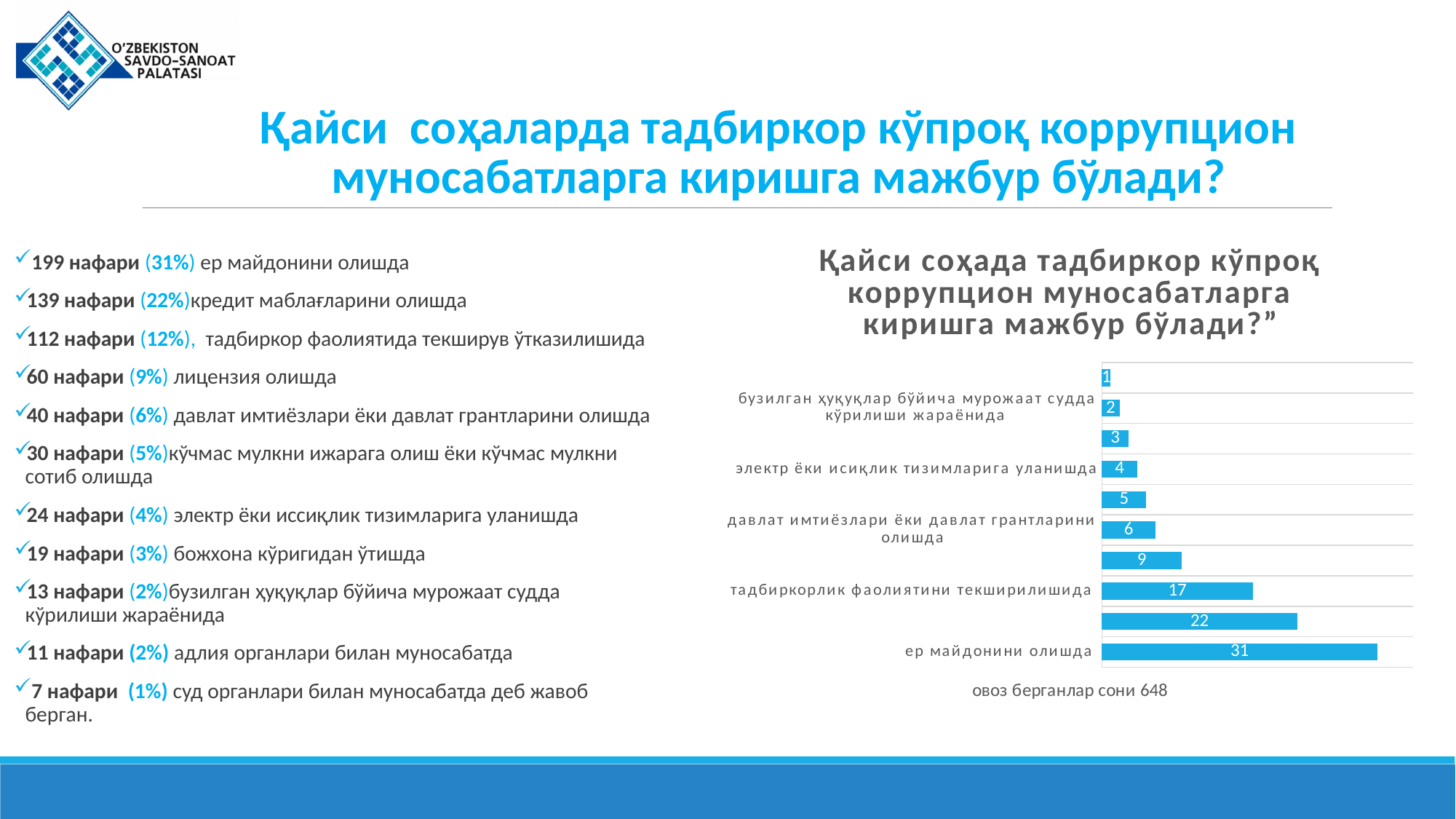
In the bar chart, what is the value for "ер майдонини олишда"? 31 What is the difference between the values for "ер майдонини олишда" and "тадбиркорлик фаолиятини текширилишида" in the bar chart? 14 What is the smallest value shown on any bar in the chart? 1 In the bar chart, what is the value for "тадбиркорлик фаолиятини текширилишида"? 17 In the bar chart, what is the value for "давлат имтиёзлари ёки давлат грантларини олишда"? 6 According to the note below the bar chart, how many people voted (овоз берганлар сони)? 648 In the bar chart, which is larger: the value for "давлат имтиёзлари ёки давлат грантларини олишда" or for "электр ёки исиқлик тизимларига уланишда"? давлат имтиёзлари ёки давлат грантларини олишда Which category has the highest value in the bar chart? ер майдонини олишда How many bars are plotted in the bar chart? 10 In the bar chart, what is the value for "электр ёки исиқлик тизимларига уланишда"? 4 In the bar chart, what is the value for "бузилган ҳуқуқлар бўйича мурожаат судда кўрилиши жараёнида"? 2 What kind of chart is shown on the right side of the slide? bar chart